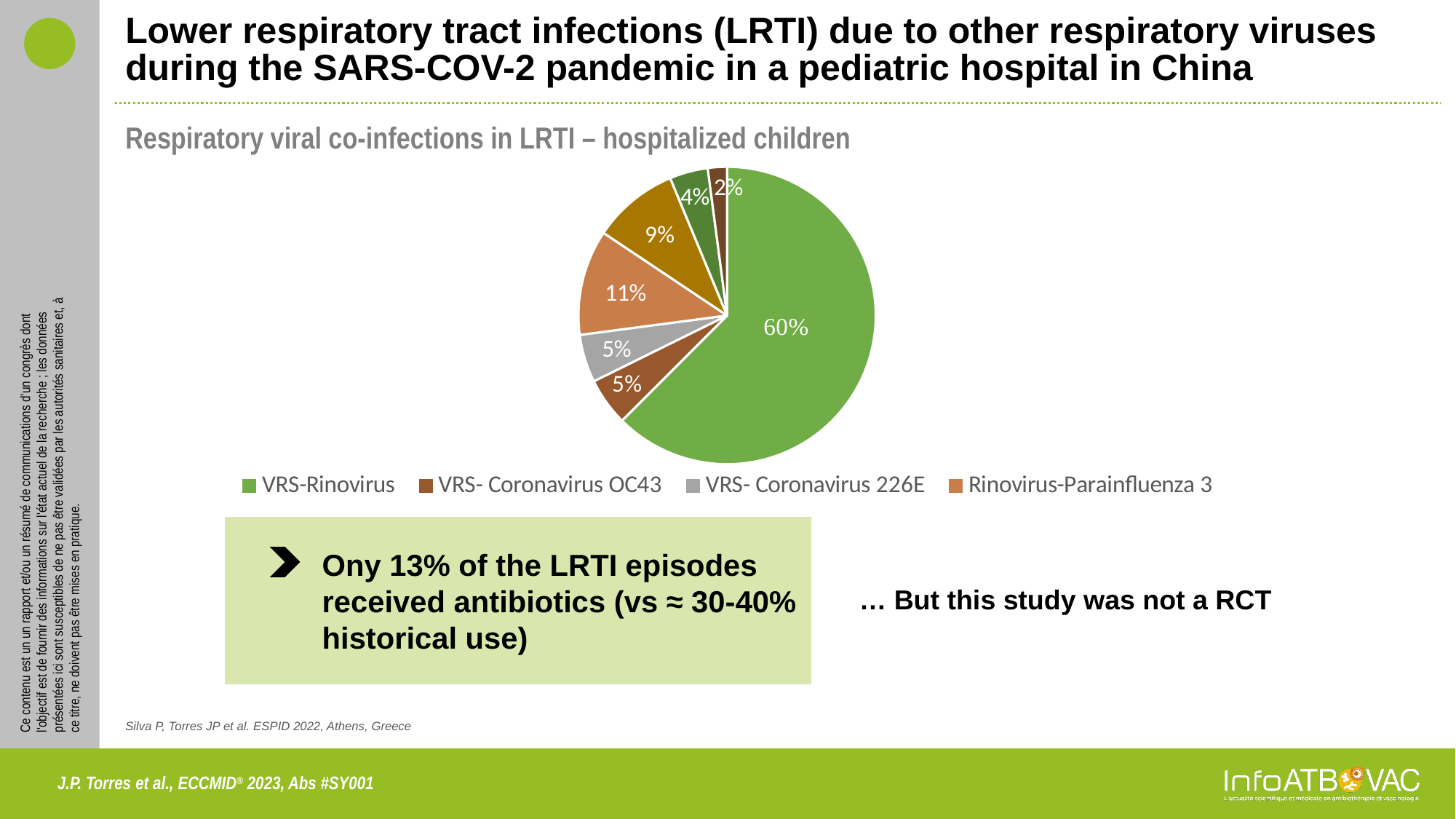
How many slices does the pie chart have? 7 What percentage of the pie chart is VRS- Coronavirus OC43? 5% How many entries does the legend of the pie chart list? 4 What percentage of the pie chart is Rinovirus-Parainfluenza 3? 11% What is the title of the chart on the slide? Respiratory viral co-infections in LRTI – hospitalized children What is the difference in percentage points between the VRS-Rinovirus slice and the Rinovirus-Parainfluenza 3 slice? 49 Which slice is larger: VRS-Rinovirus or Rinovirus-Parainfluenza 3? VRS-Rinovirus Which co-infection has the largest share of the pie chart? VRS-Rinovirus What percentage of the pie chart is VRS-Rinovirus? 60% What is the smallest percentage labelled on the pie chart? 2% What percentage of the pie chart is VRS- Coronavirus 226E? 5% What type of chart is shown on the slide? Pie chart